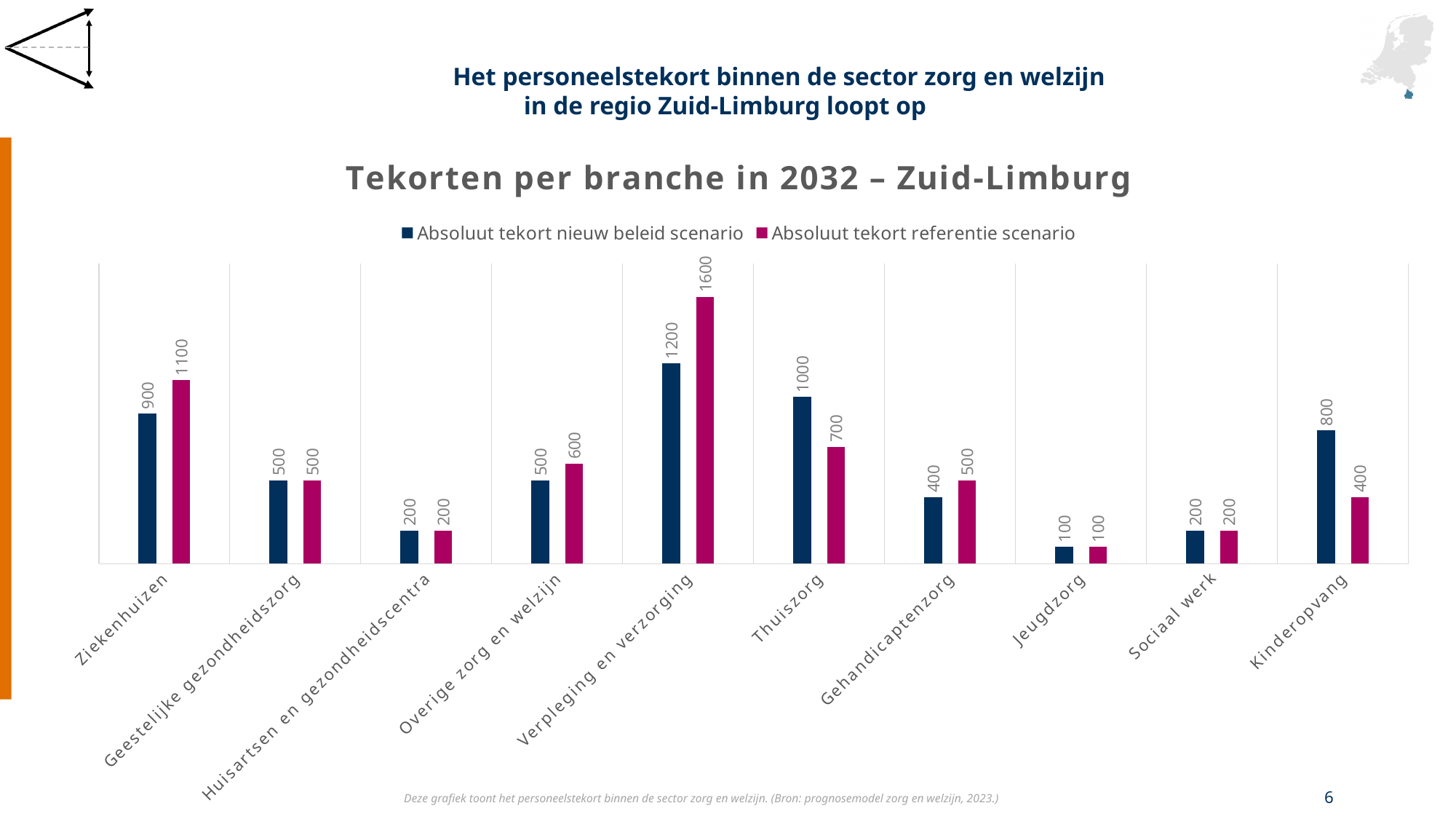
What is the value for Thuiszorg in the 'Absoluut tekort nieuw beleid scenario' series? 1000 What is the title of the chart? Tekorten per branche in 2032 – Zuid-Limburg What is the value for Kinderopvang in the 'Absoluut tekort referentie scenario' series? 400 What is the difference between the 'Absoluut tekort nieuw beleid scenario' values for Kinderopvang and Gehandicaptenzorg? 400 Which category has the lowest value in the 'Absoluut tekort nieuw beleid scenario' series? Jeugdzorg What is the value for Ziekenhuizen in the 'Absoluut tekort referentie scenario' series? 1100 How many series does the legend list? 2 For Thuiszorg, which series has the larger value: 'Absoluut tekort nieuw beleid scenario' or 'Absoluut tekort referentie scenario'? Absoluut tekort nieuw beleid scenario What kind of chart is shown on the slide? Bar chart Which category has the highest value in the 'Absoluut tekort referentie scenario' series? Verpleging en verzorging What is the difference between the two series for Verpleging en verzorging? 400 How many categories are shown on the x axis? 10